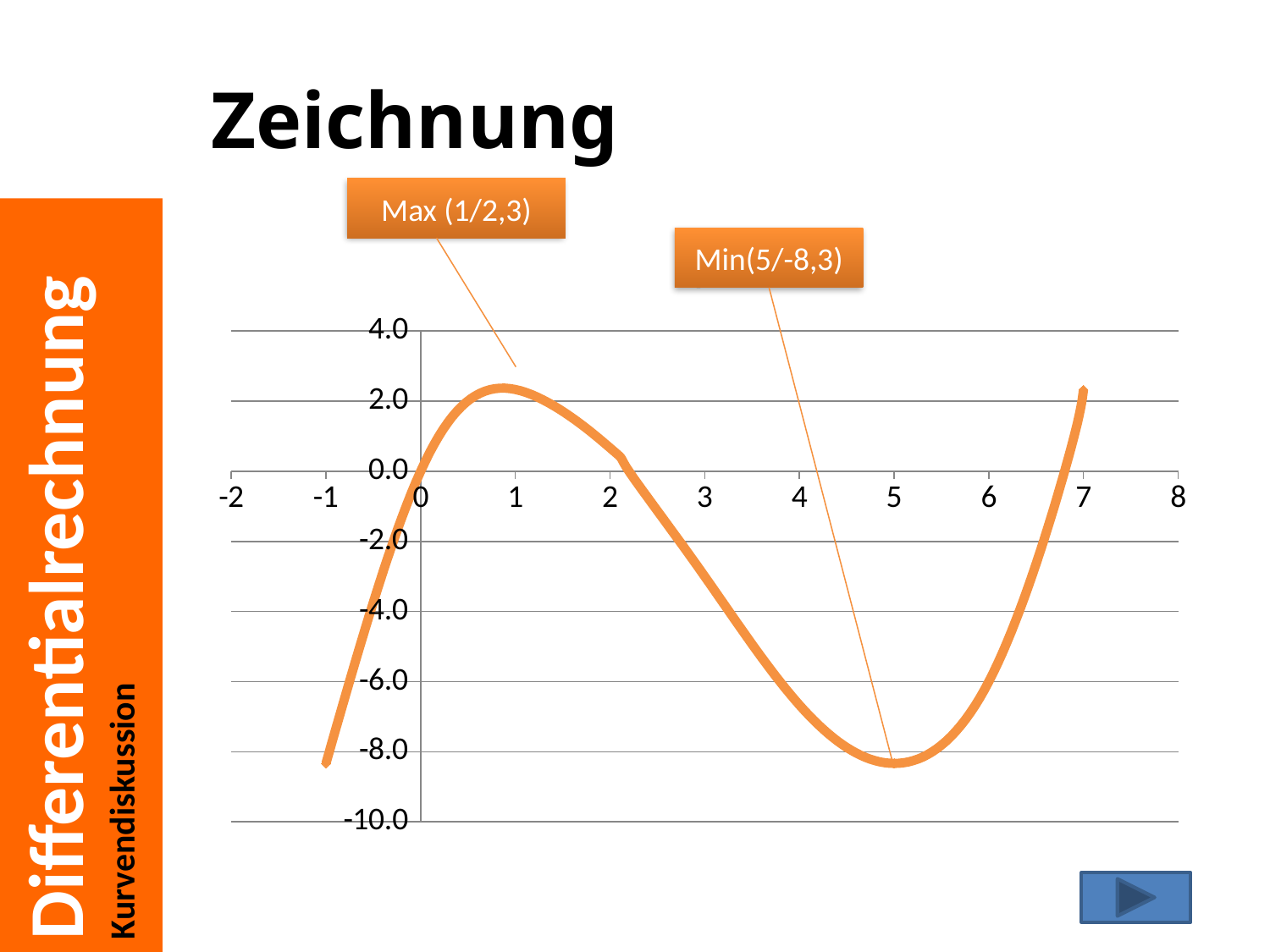
Is the value of the curve at x = 4 greater or less than -4.0? less Does the curve rise or fall between x = 1 and x = 5? fall What does the annotation for the maximum of the curve say? Max (1/2,3) What kind of chart is shown on the slide? line chart Is the value of the curve at x = -1 greater or less than -6.0? less Is the value of the curve at x = 7 greater or less than 0.0? greater According to the annotation, what is the y-value of the minimum of the curve? -8,3 According to the annotation, at which x-value does the minimum of the curve occur? 5 What is the title of the slide containing the chart? Zeichnung What is the lowest value shown on the y axis? -10.0 Does the curve rise or fall between x = 5 and x = 7? rise